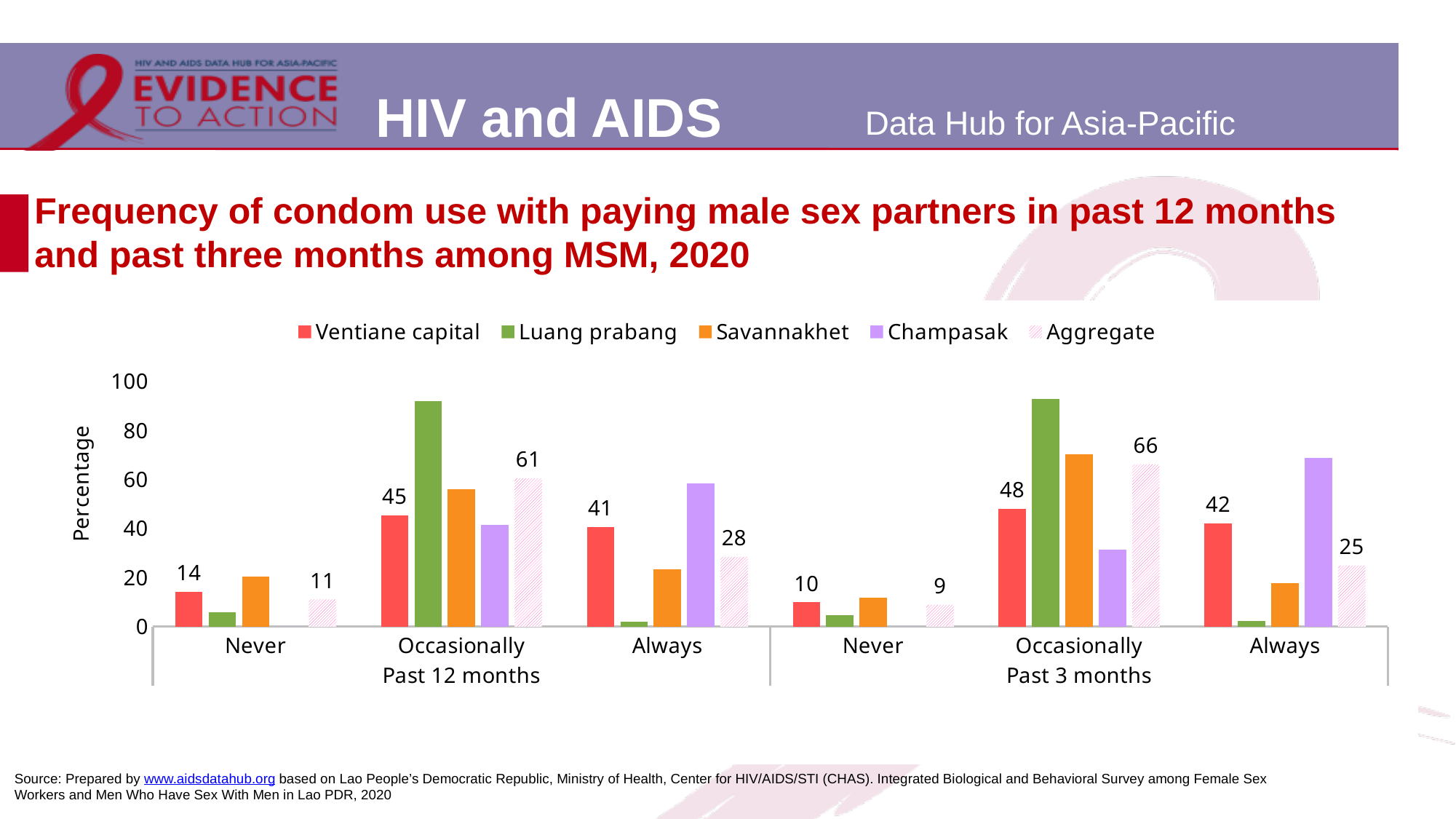
What is the value for Ventiane capital in the Never category for the past 12 months? 14 What kind of chart is shown on the slide? Bar chart Is the value for Champasak in the Always category for the past 3 months greater or less than 60? greater Which category has the highest value for Ventiane capital? Occasionally, past 3 months How many series does the legend list? 5 Is the value for Luang prabang in the Occasionally category for the past 12 months greater or less than 80? greater What is the value for Ventiane capital in the Always category for the past 3 months? 42 For the past 3 months, how much higher is the Ventiane capital value for Occasionally than for Never? 38 Which category has the lowest Aggregate value? Never, past 3 months What is the Aggregate value for Occasionally in the past 3 months? 66 In the Always category for the past 12 months, which is larger: Ventiane capital or Aggregate? Ventiane capital What is the difference between the Aggregate values for Occasionally in the past 3 months and in the past 12 months? 5